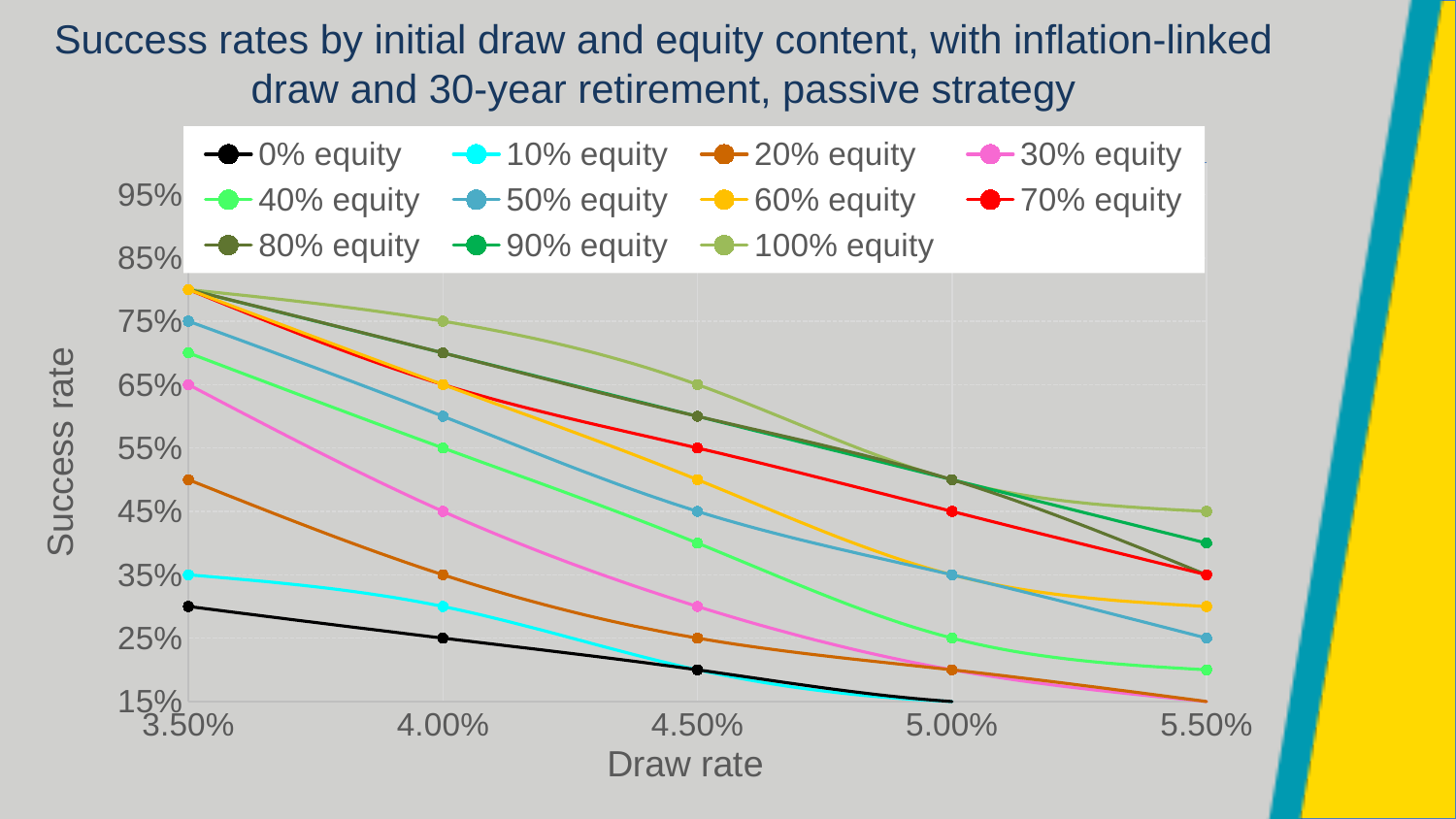
Which equity series has the lowest success rate at a 3.50% draw rate? 0% equity What is the title of the x axis? Draw rate What is the success rate for 0% equity at a 5.00% draw rate? 15% How many series does the legend list? 11 How many draw rates are plotted along the x axis? 5 At a 4.50% draw rate, which has the higher success rate: 50% equity or 40% equity? 50% equity What is the success rate for 50% equity at a 3.50% draw rate? 75% Which equity series has the highest success rate at a 5.50% draw rate? 100% equity What kind of chart is shown on the slide? line chart Do the success rates rise or fall as the draw rate increases? fall Is the success rate for 80% equity at a 4.00% draw rate greater or less than 65%? greater What is the success rate for 70% equity at a 4.50% draw rate? 55%